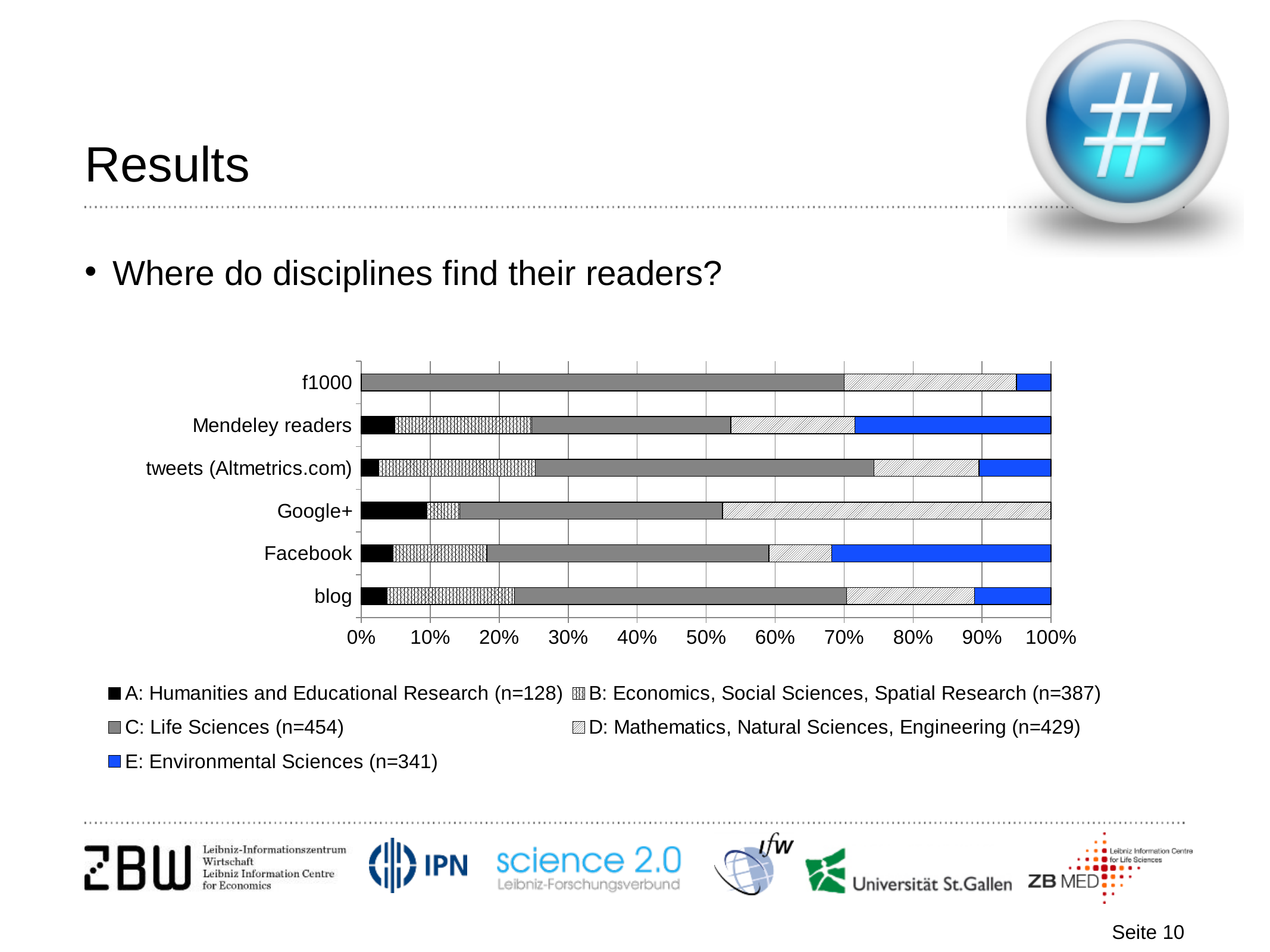
Which platform has the largest share for C: Life Sciences? f1000 What is the sample size (n) given in the legend for C: Life Sciences? 454 Is the share of E: Environmental Sciences in the Mendeley readers bar greater or less than 20%? greater Is the share of A: Humanities and Educational Research in the Google+ bar greater or less than 20%? less How many series does the chart's legend list? 5 Which platform shows no segment for E: Environmental Sciences? Google+ Which legend entry is shown in blue? E: Environmental Sciences (n=341) Is the share of C: Life Sciences in the f1000 bar greater or less than 60%? greater Which platform has the largest share for A: Humanities and Educational Research? Google+ What kind of chart is shown on the slide? stacked bar chart How many categories (platforms) are shown on the y axis of the chart? 6 Is the share of C: Life Sciences larger for f1000 or for blog? f1000